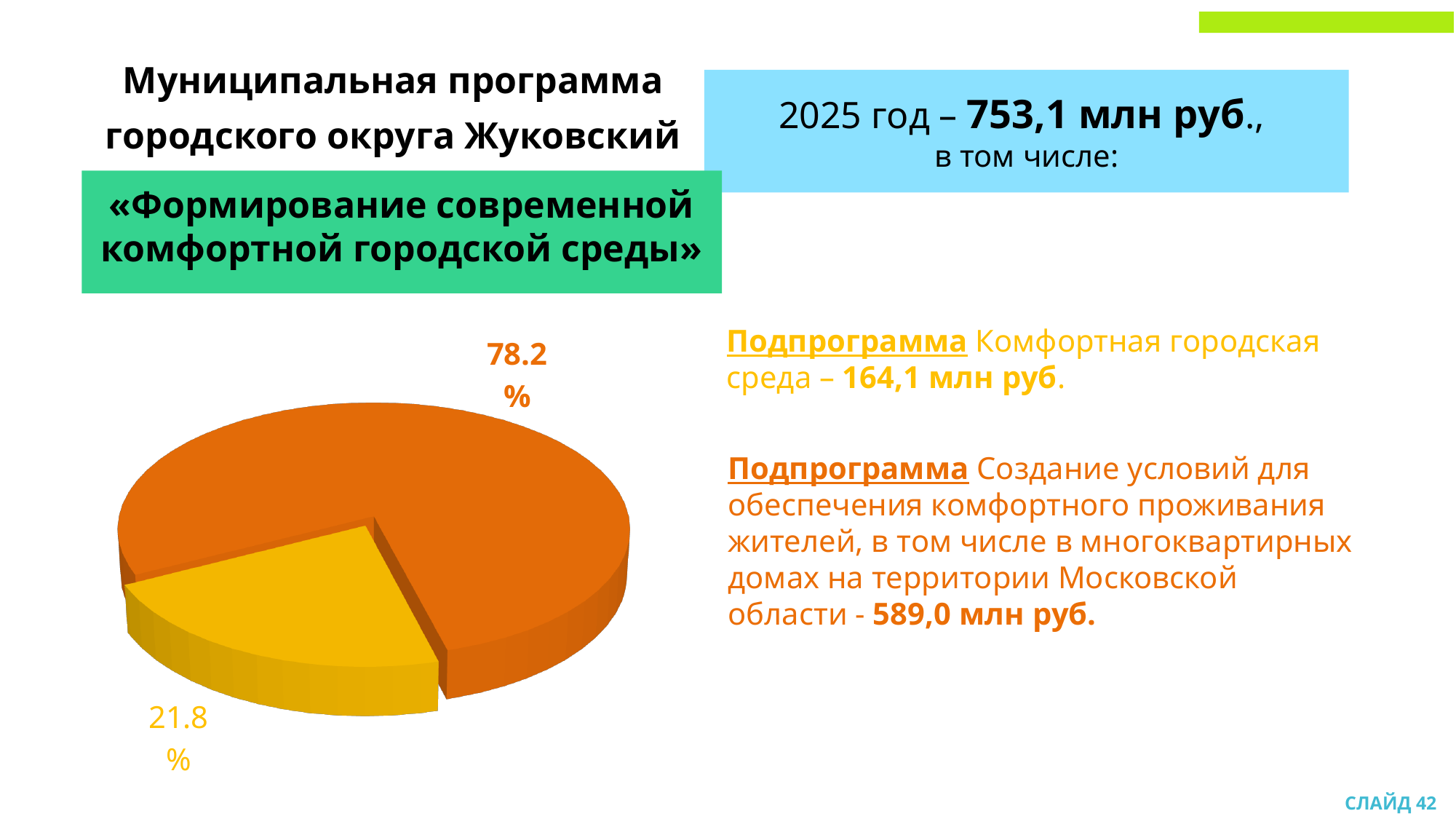
Which slice of the pie chart is the largest? the orange slice (78.2%) What kind of chart is shown on the slide? pie chart What share of the pie does the orange slice represent? 78.2% What share of the pie does the yellow slice represent? 21.8% What is the total of the two slice percentages shown on the pie chart? 100% Is the share of the yellow slice greater or less than 25%? less Which slice of the pie chart is the smallest? the yellow slice (21.8%) By how many percentage points does the orange slice exceed the yellow slice? 56.4 percentage points Is the share of the orange slice greater or less than 75%? greater How many slices does the pie chart have? 2 Which is larger, the orange slice or the yellow slice? the orange slice What colour is the slice labelled 21.8%? yellow